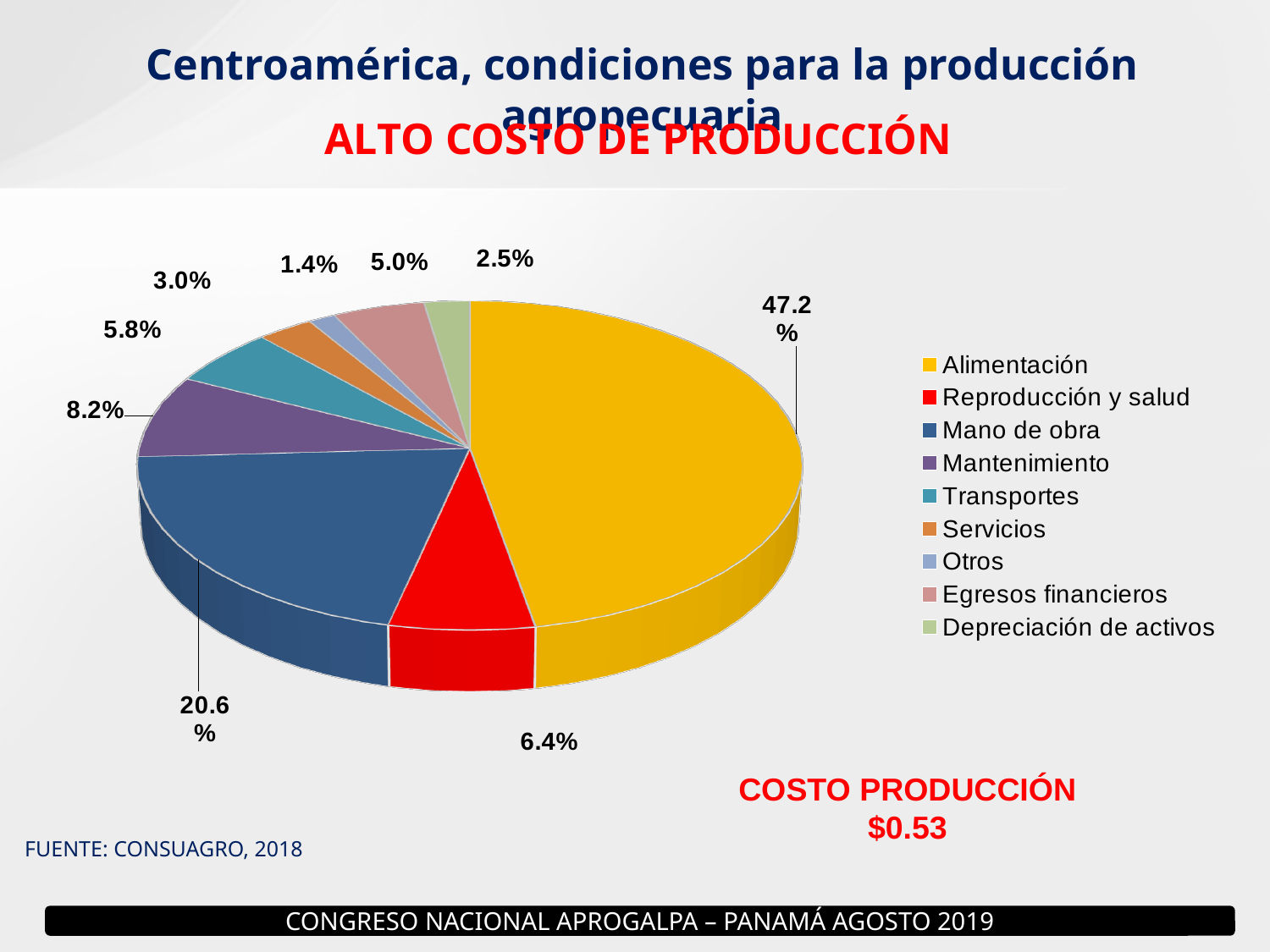
What is the value shown for Mano de obra? 20.6% Which is larger, the share for Transportes or the share for Egresos financieros? Transportes What kind of chart is shown on the slide? Pie chart What share of the pie does Alimentación represent? 47.2% Which category has the largest share of the pie? Alimentación What is the difference between the shares of Alimentación and Mano de obra? 26.6% What is the value for Reproducción y salud? 6.4% How many categories does the legend list? 9 What is the combined share of Servicios and Depreciación de activos? 5.5% What percentage is shown for Mantenimiento? 8.2% What colour is the Alimentación slice in the pie chart? Yellow Which category has the smallest share of the pie? Otros